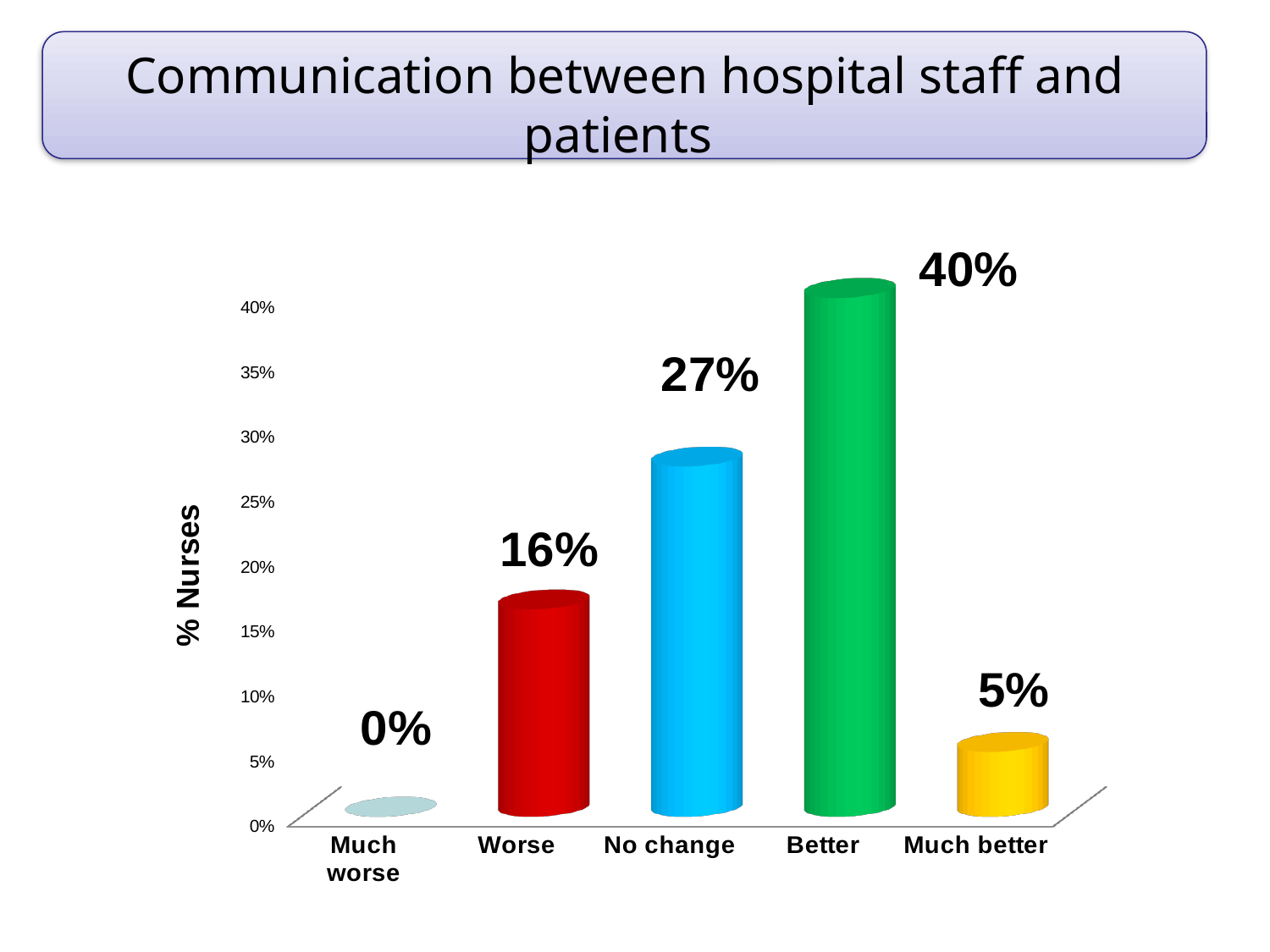
How many categories are shown on the x axis? 5 What kind of chart is shown on the slide? bar chart Which category has the highest value? Better What is the label of the vertical axis? % Nurses What is the value for "Much worse"? 0% What percentage of nurses answered "Better"? 40% What is the value for "No change"? 27% Is the value for "Worse" greater or less than 20%? less What is the difference between the values for "Better" and "Worse"? 24% What is the value for "Much better"? 5% Which is larger, the value for "No change" or the value for "Worse"? No change Which category has the lowest value? Much worse